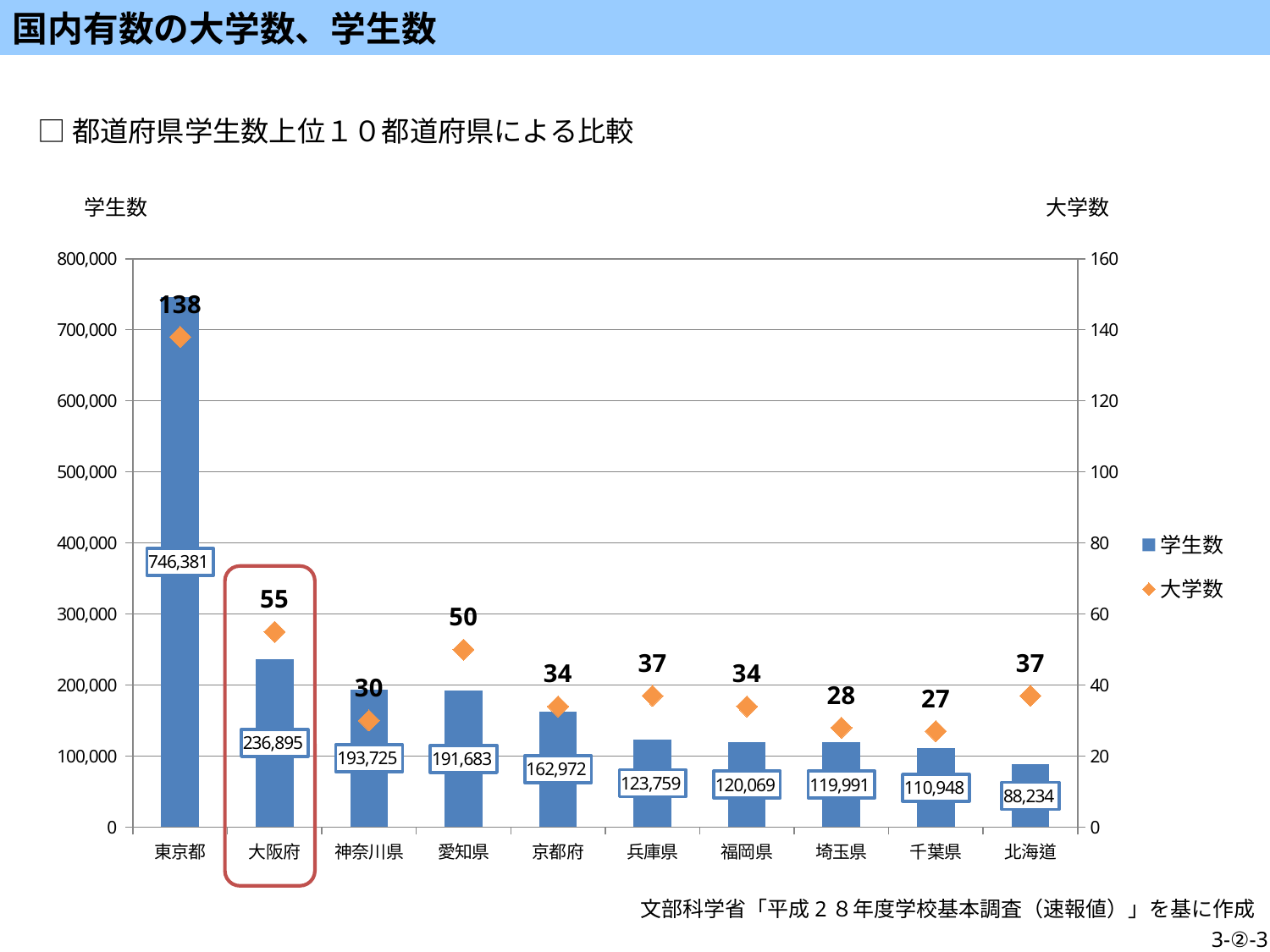
Which prefecture is highlighted with a red rounded outline? 大阪府 How many prefectures are shown on the x axis? 10 Which has a larger 学生数, 神奈川県 or 愛知県? 神奈川県 Which has a larger 大学数, 兵庫県 or 埼玉県? 兵庫県 How many series does the legend list? 2 What is the 学生数 value for 北海道? 88,234 What is the 大学数 value for 愛知県? 50 Which prefecture has the highest 学生数? 東京都 Which prefecture has the lowest 大学数? 千葉県 What is the 学生数 value for 大阪府? 236,895 What is the difference in 大学数 between 大阪府 and 神奈川県? 25 What is the difference in 学生数 between 東京都 and 大阪府? 509,486